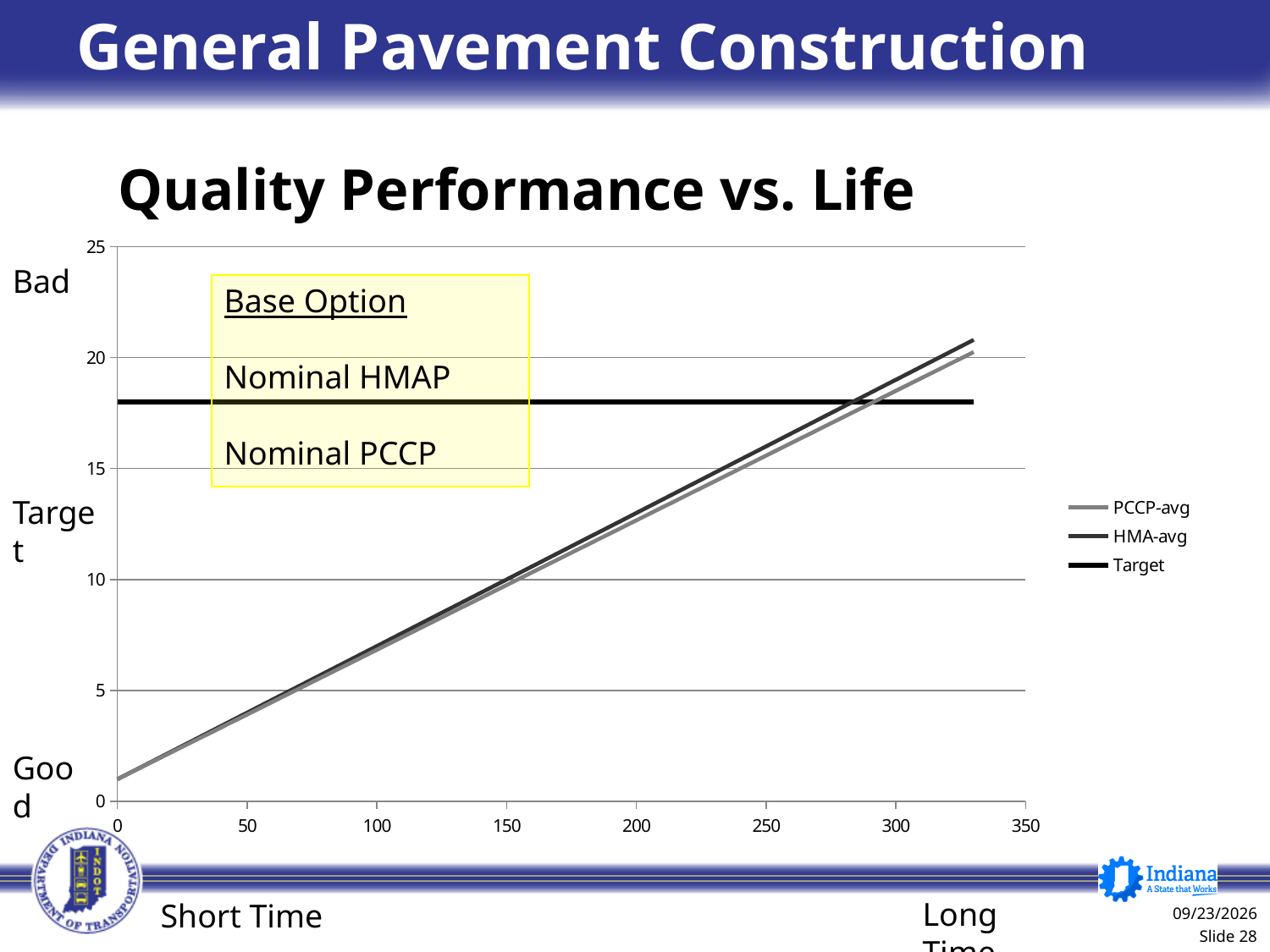
What kind of chart is shown on the slide? line chart How many series does the chart legend list? 3 Is the Target line greater or less than 15 on the y axis? greater Which series are listed in the chart legend? PCCP-avg, HMA-avg, Target What is the highest value shown on the x axis? 350 Is the Target line greater or less than 20 on the y axis? less Does the Target line rise, fall, or stay flat along the x axis? stay flat Is the value of PCCP-avg at x = 50 greater or less than 5? less Do the PCCP-avg and HMA-avg lines rise or fall as the x axis increases? rise What is the title of the chart? Quality Performance vs. Life